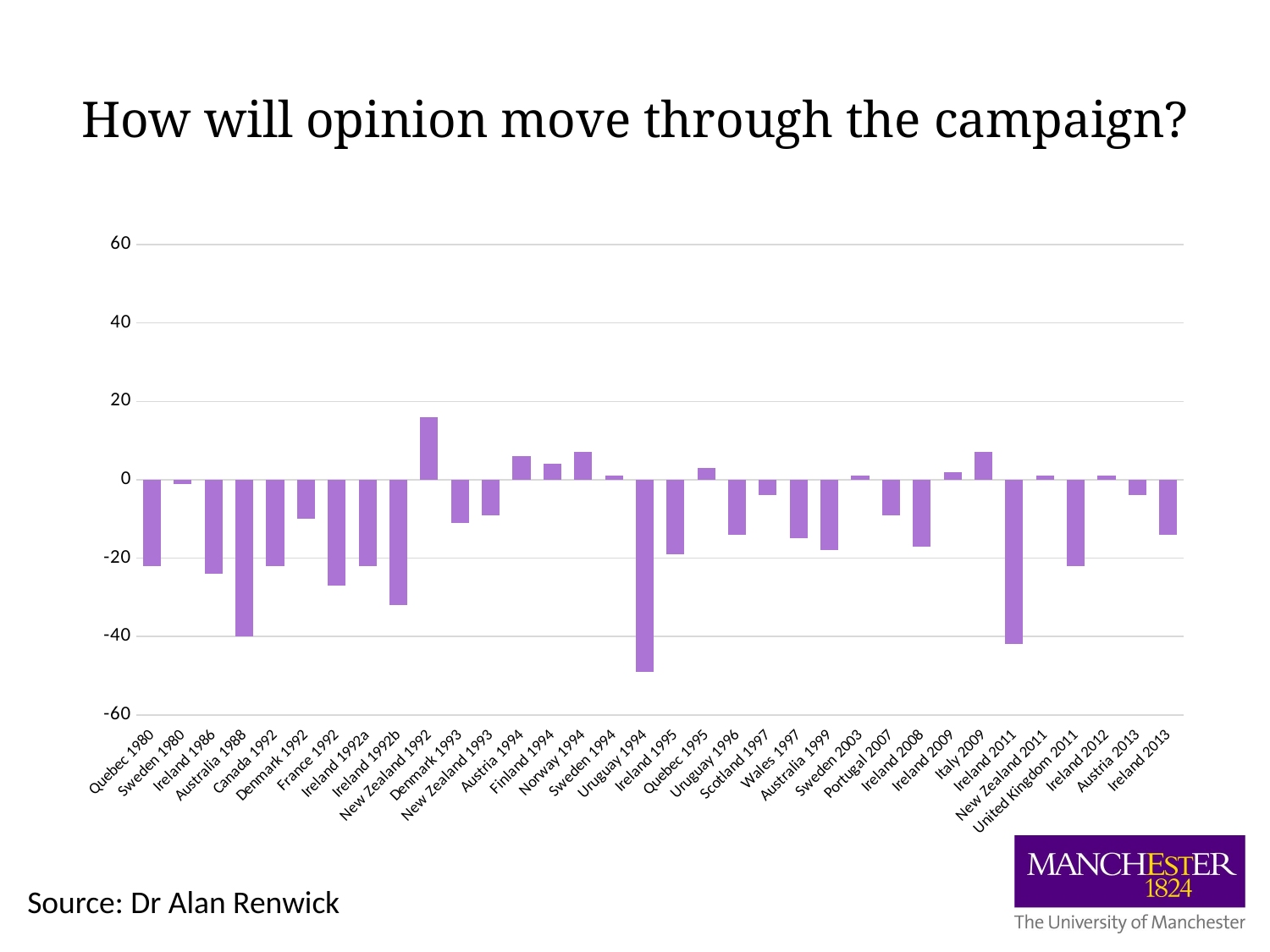
Which has the larger value, Uruguay 1994 or Ireland 2011? Ireland 2011 Which category has the lowest value? Uruguay 1994 What is the title of the chart on the slide? How will opinion move through the campaign? Is the value for Ireland 2011 greater or less than -40? less How many categories (referendums) are plotted on the x axis? 34 What kind of chart is shown on the slide? bar chart Which has the larger value, Quebec 1980 or Sweden 1980? Sweden 1980 Is the value for Quebec 1980 greater or less than -20? less Is the value for New Zealand 1992 greater or less than 20? less Which category has the highest value? New Zealand 1992